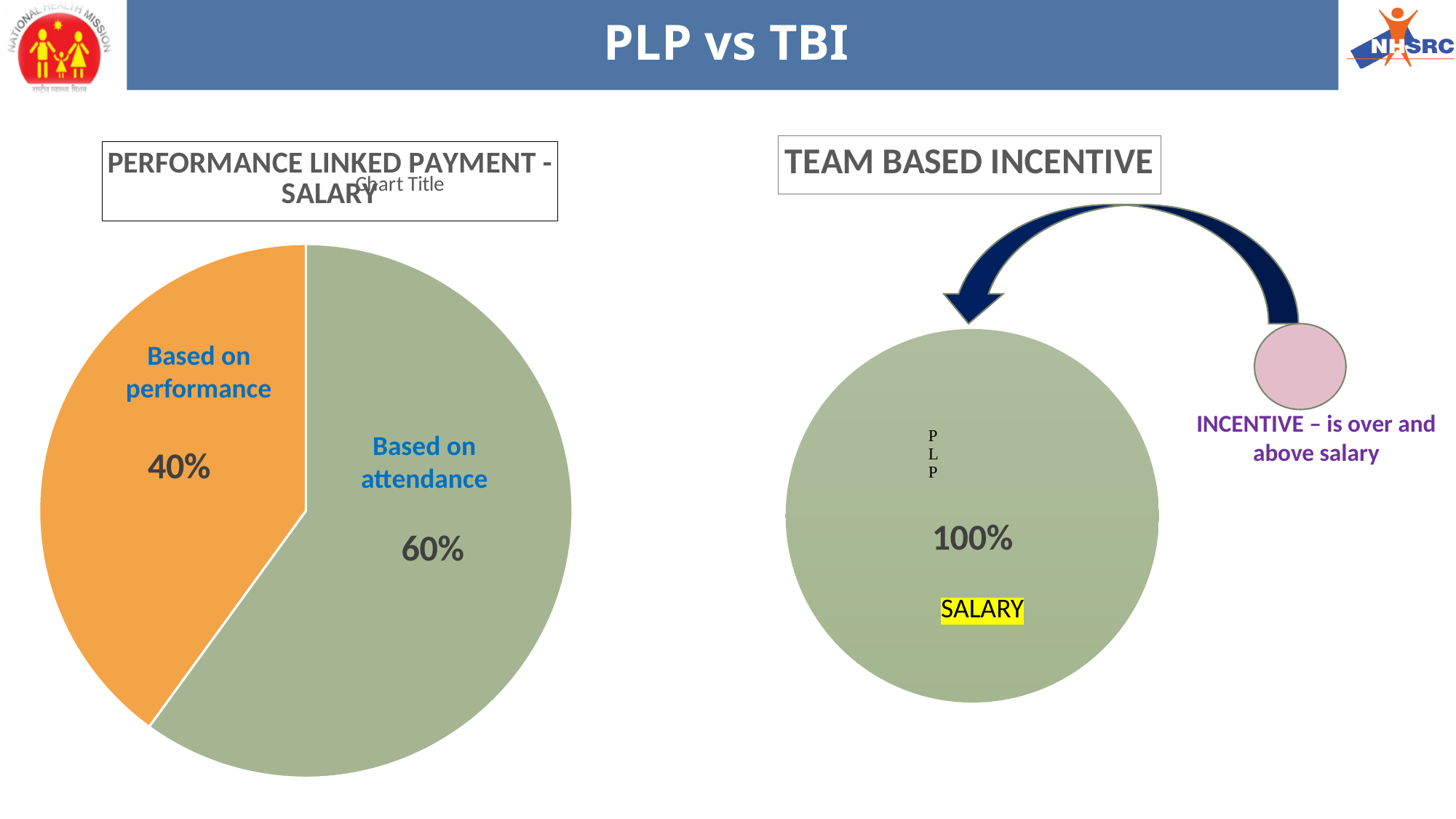
In the Performance Linked Payment - Salary chart, which slice is the smallest? Based on performance How many slices does the Performance Linked Payment - Salary pie chart have? 2 In the Team Based Incentive chart, what percentage is shown for salary? 100% In the Performance Linked Payment - Salary chart, do the two slices add up to 100%? Yes In the Performance Linked Payment - Salary chart, what share is based on attendance? 60% What type of chart is the Performance Linked Payment - Salary chart? Pie chart In the Performance Linked Payment - Salary chart, what colour is the 'Based on performance' slice? Orange In the Performance Linked Payment - Salary chart, which is larger: the share based on performance or the share based on attendance? Based on attendance In the Performance Linked Payment - Salary chart, what is the difference between the attendance-based share and the performance-based share? 20% In the Performance Linked Payment - Salary chart, which slice is the largest? Based on attendance What is the title of the chart on the right side of the slide? Team Based Incentive In the Performance Linked Payment - Salary chart, what share is based on performance? 40%